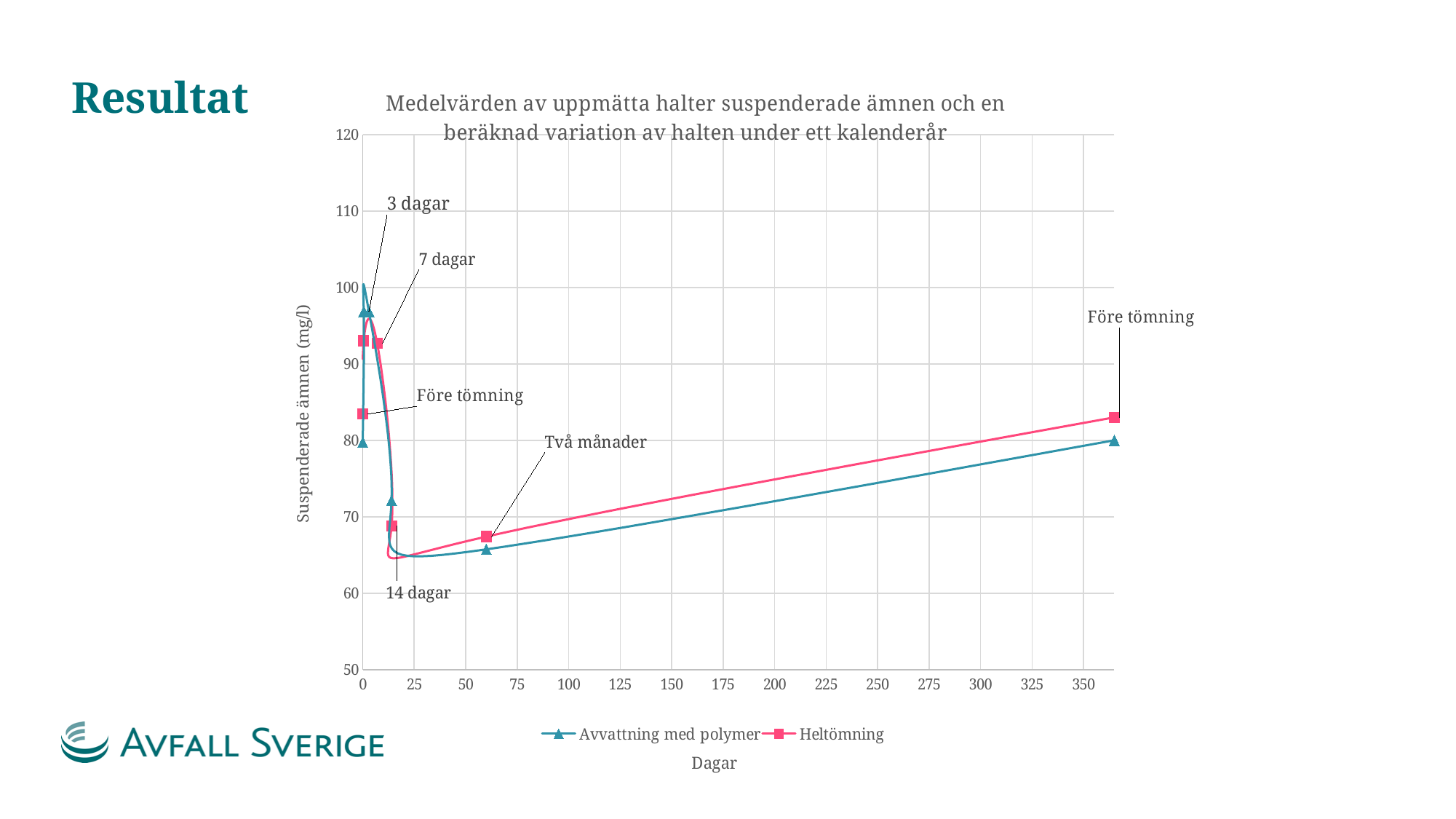
What kind of chart is shown on the slide? line chart How many data points are plotted for the Heltömning series? 6 How many series does the legend list? 2 At the final Före tömning point (around 365 days), which series has the higher value, Avvattning med polymer or Heltömning? Heltömning Is the value for Avvattning med polymer at 3 dagar greater or less than 90? greater At 3 dagar, which series has the higher value, Avvattning med polymer or Heltömning? Avvattning med polymer Is the value for Heltömning at Två månader greater or less than 70? less What are the two series named in the legend? Avvattning med polymer and Heltömning Is the value for Avvattning med polymer at 14 dagar greater or less than 80? less Do the values for both series rise or fall between Två månader and the end of the x axis? rise What is the label of the y axis? Suspenderade ämnen (mg/l)